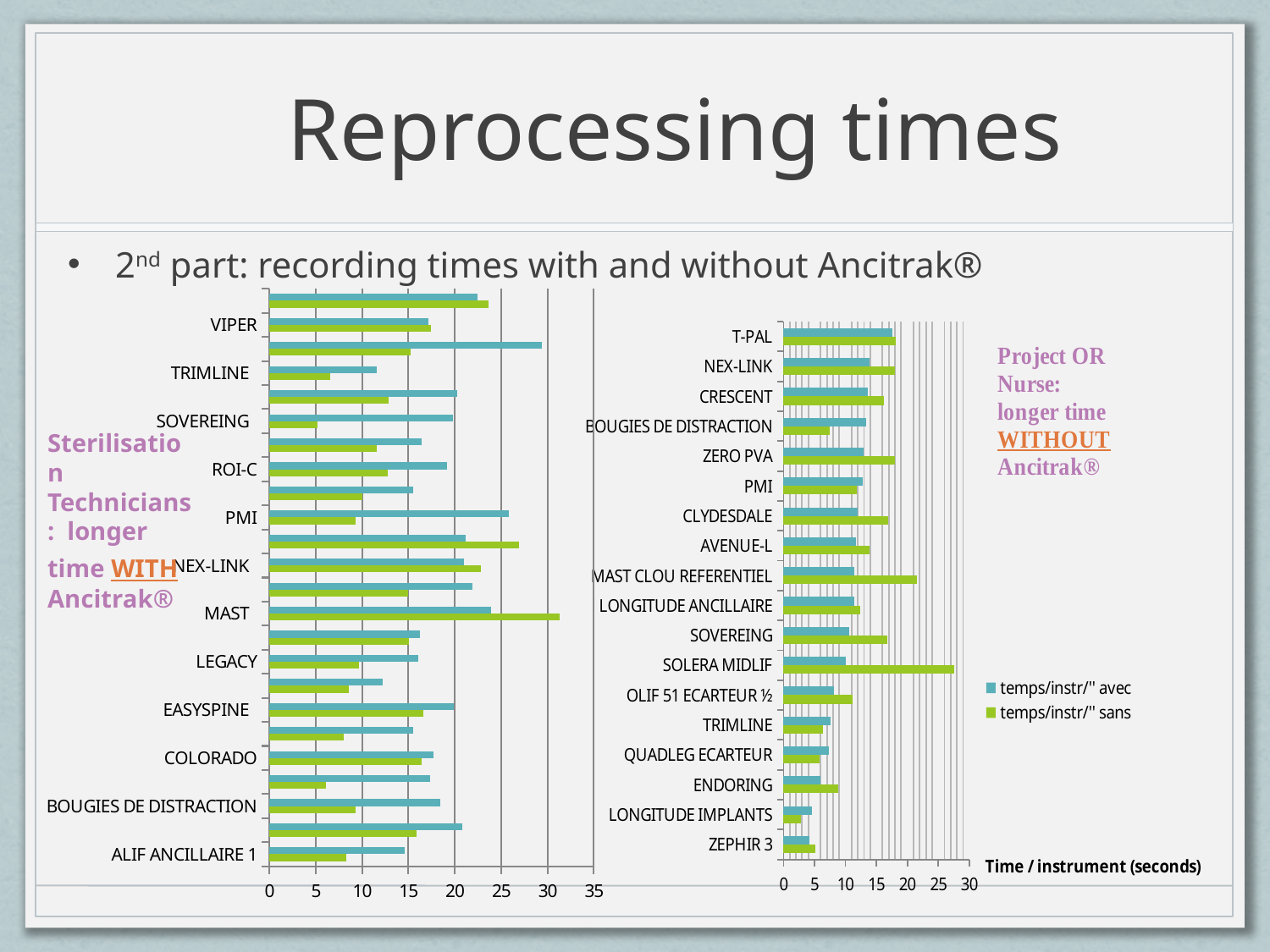
What is the x-axis title shown under the right chart? Time / instrument (seconds) On the right chart, which category has the shortest 'temps/instr/'' sans' (green) bar? LONGITUDE IMPLANTS How many categories are labelled on the right chart (Project OR Nurse)? 18 On the right chart, for BOUGIES DE DISTRACTION, which series has the larger value: 'temps/instr/'' avec' or 'temps/instr/'' sans'? temps/instr/'' avec On the right chart, which category has the longest 'temps/instr/'' sans' (green) bar? SOLERA MIDLIF How many series does the legend on the right chart list? 2 On the right chart, is the 'temps/instr/'' sans' value for SOLERA MIDLIF greater or less than 25? greater On the right chart, is the 'temps/instr/'' avec' value for ZEPHIR 3 greater or less than 5? less On the right chart, is the 'temps/instr/'' sans' value for MAST CLOU REFERENTIEL greater or less than 20? greater On the right chart, for ENDORING, which series has the larger value: 'temps/instr/'' avec' or 'temps/instr/'' sans'? temps/instr/'' sans What kind of chart is the left chart (Sterilisation Technicians)? bar chart On the right chart, which category has the longest 'temps/instr/'' avec' (blue) bar? T-PAL